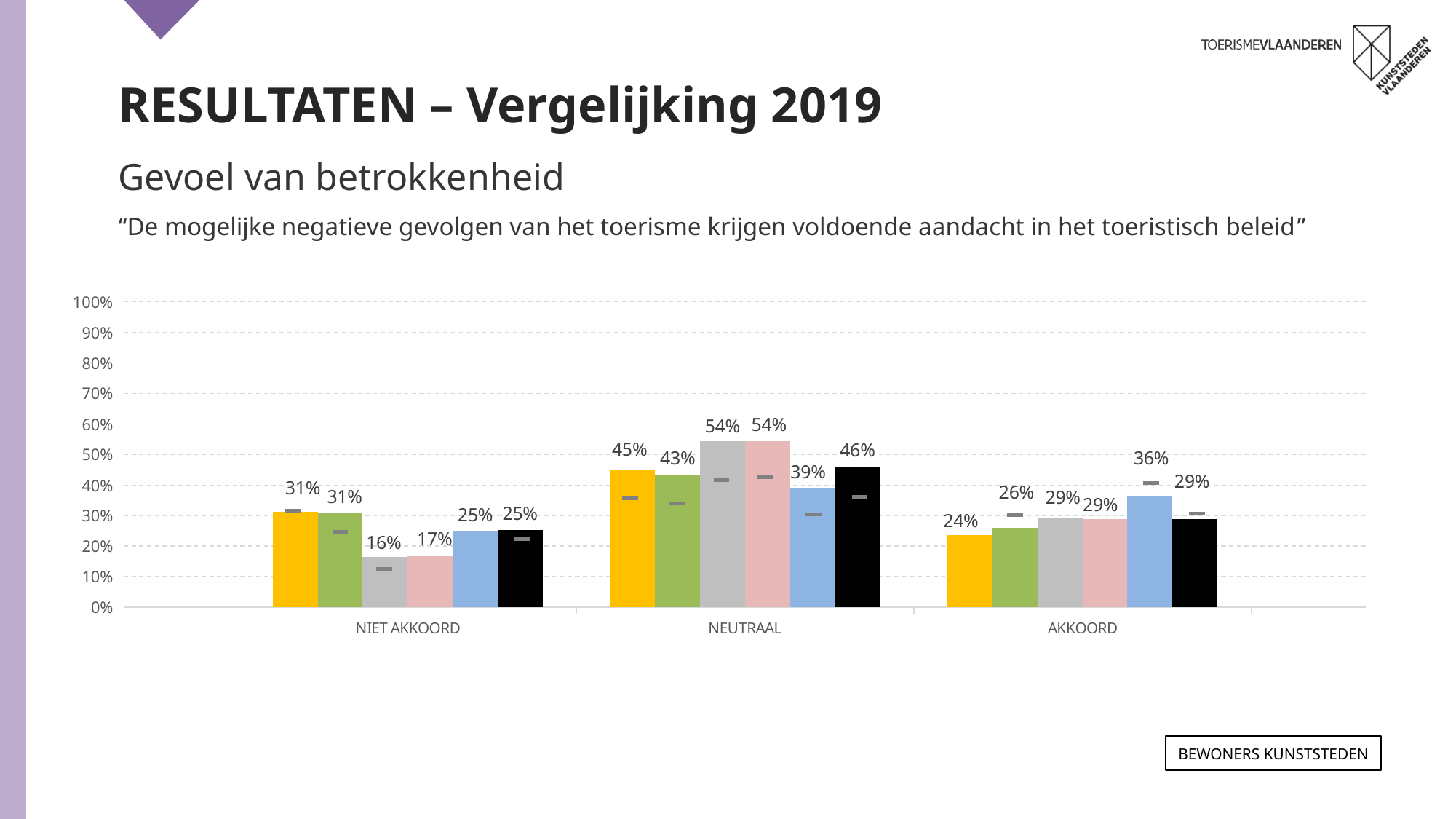
How many categories are shown on the x axis of the chart? 3 What is the difference between the blue bar and the yellow bar in the AKKOORD category? 12% What is the value of the yellow bar in the NEUTRAAL category? 45% What type of chart is shown on the slide? bar chart What is the value of the grey bar in the NIET AKKOORD category? 16% What statement is the chart about, as quoted on the slide? "De mogelijke negatieve gevolgen van het toerisme krijgen voldoende aandacht in het toeristisch beleid" Is the value of the pink bar in the NEUTRAAL category larger than the value of the blue bar in the same category? yes How many bars are plotted in each category of the chart? 6 What is the value of the blue bar in the AKKOORD category? 36% Which category has the highest value for the grey bar? NEUTRAAL What is the value of the black bar in the NEUTRAAL category? 46% Which bar has the lowest value in the AKKOORD category? the yellow bar (24%)